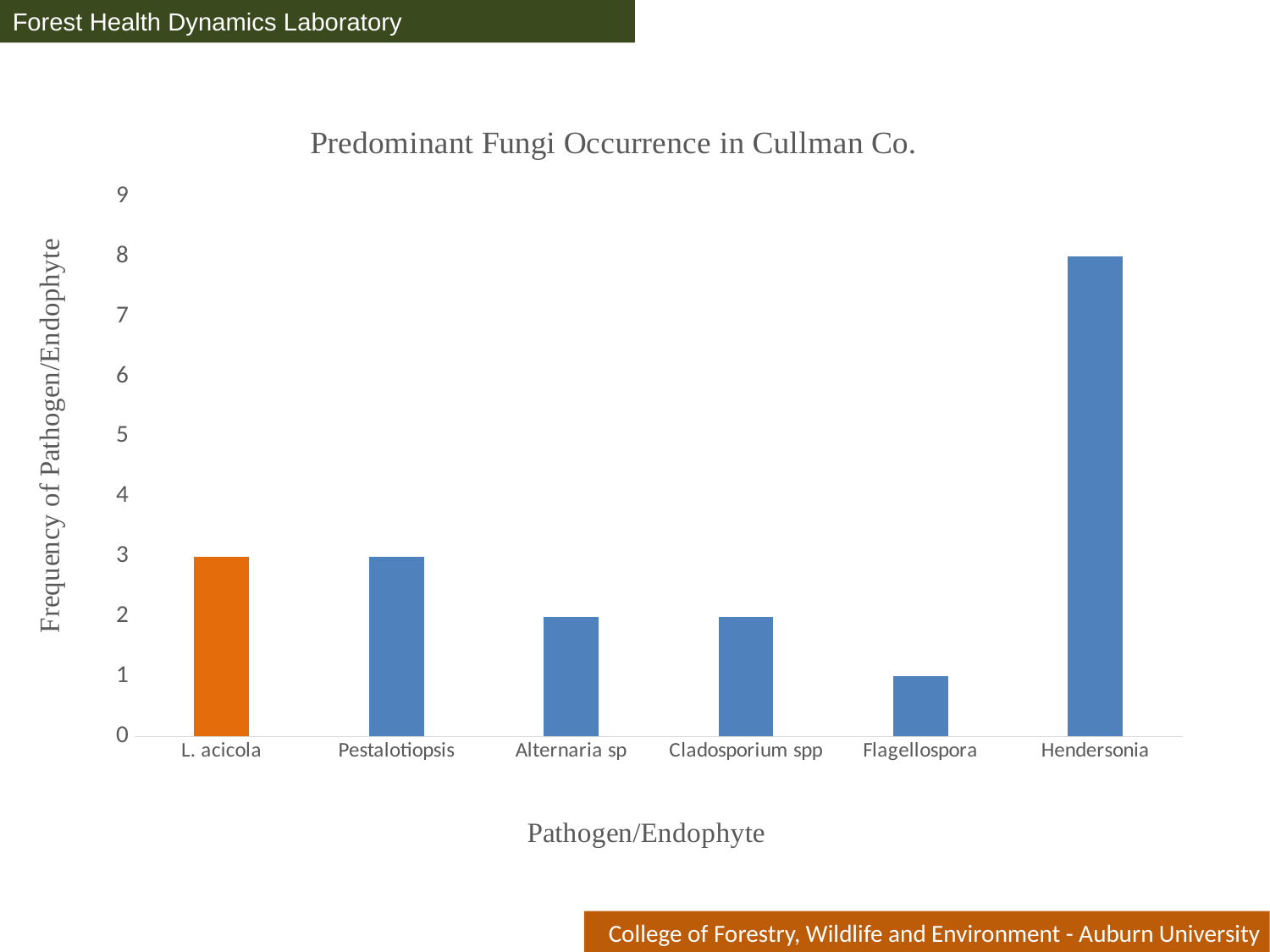
Is the value for Hendersonia greater or less than 5? greater What is the title of the chart? Predominant Fungi Occurrence in Cullman Co. Which bar is coloured differently (orange) from the others? L. acicola What is the frequency for Hendersonia? 8 What type of chart is shown on the slide? bar chart What is the frequency for L. acicola? 3 Which pathogen/endophyte has the highest frequency? Hendersonia How many pathogen/endophyte categories are shown on the x axis? 6 Which has a higher frequency, Alternaria sp or Flagellospora? Alternaria sp What is the difference in frequency between Hendersonia and Pestalotiopsis? 5 What is the frequency for Flagellospora? 1 Which pathogen/endophyte has the lowest frequency? Flagellospora